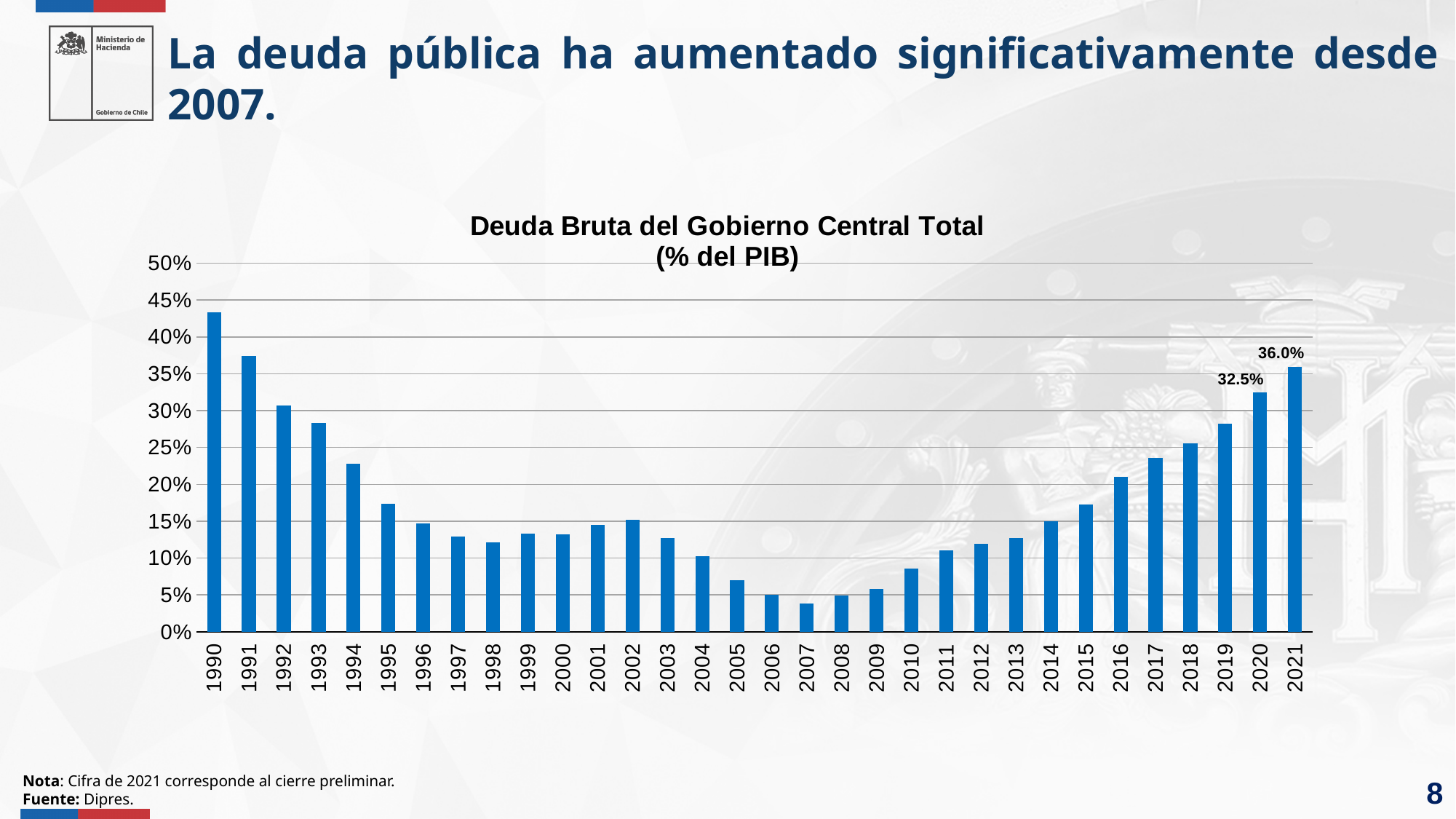
Do the values rise or fall from 2007 to 2021? Rise Which year has the highest value in the chart? 1990 Which year has the larger value, 1991 or 2019? 1991 Is the value for 2007 greater or less than 5%? less What is the title of the chart? Deuda Bruta del Gobierno Central Total (% del PIB) By how many percentage points did the value rise from 2020 to 2021? 3.5 percentage points Is the value for 1990 greater or less than 40%? greater What kind of chart is shown on the slide? Bar chart Which year has the lowest value in the chart? 2007 What is the value for 2020 in the chart? 32.5% How many years are shown on the x axis of the chart? 32 What is the value for 2021 in the chart? 36.0%